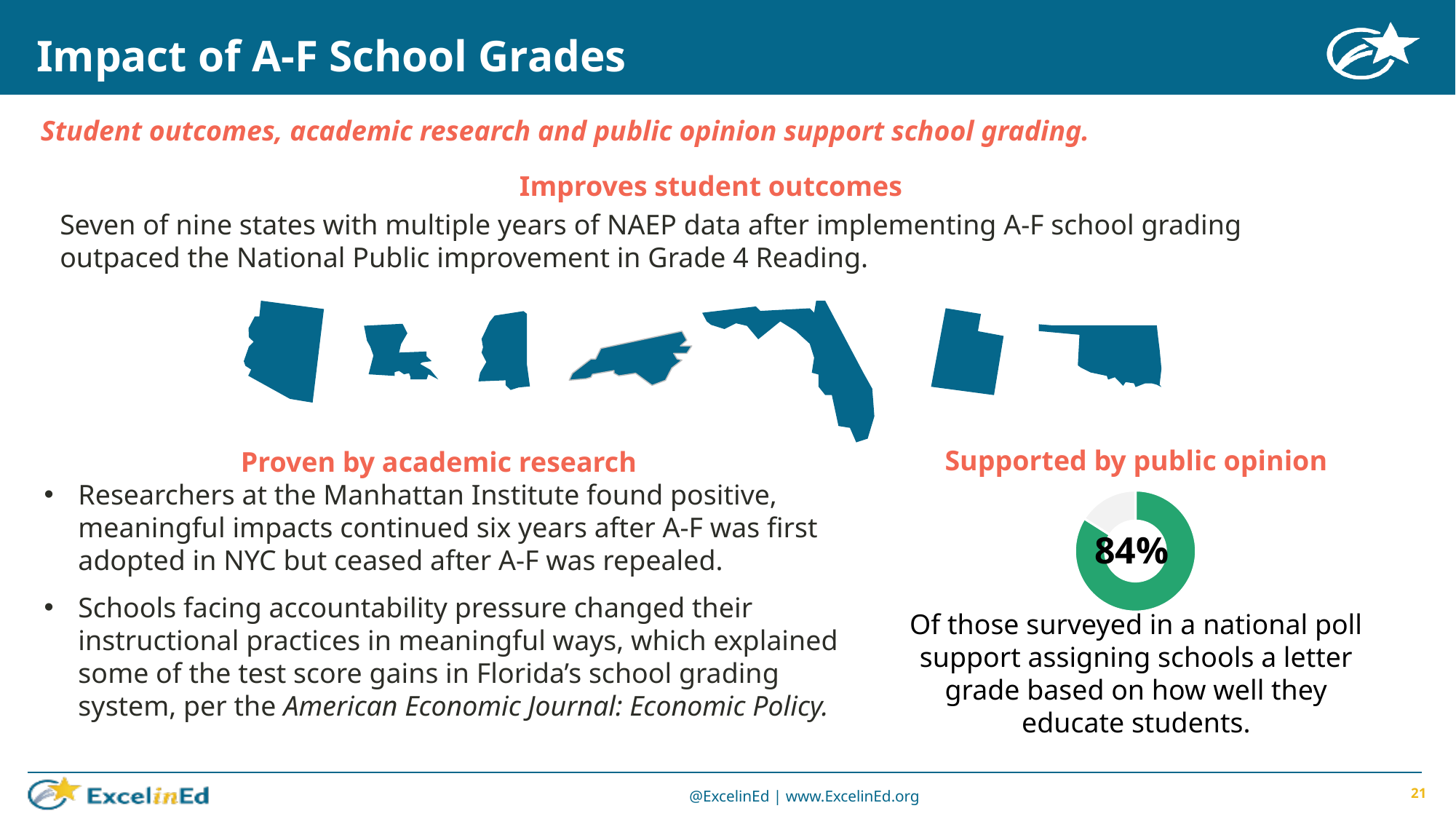
What share of the donut chart is not covered by the green segment? 16% How many segments does the donut chart have? 2 Is the value shown in the donut chart greater or less than 50%? greater What share of the donut chart is filled by the green segment? 84% According to the text below the donut chart, what does the 84% represent? Those surveyed in a national poll who support assigning schools a letter grade based on how well they educate students What colour is the filled segment of the donut chart? Green Which segment of the donut chart is larger, the green one or the grey one? The green one What percentage is shown in the centre of the donut chart under "Supported by public opinion"? 84% What kind of chart is shown under the heading "Supported by public opinion"? Donut (pie) chart